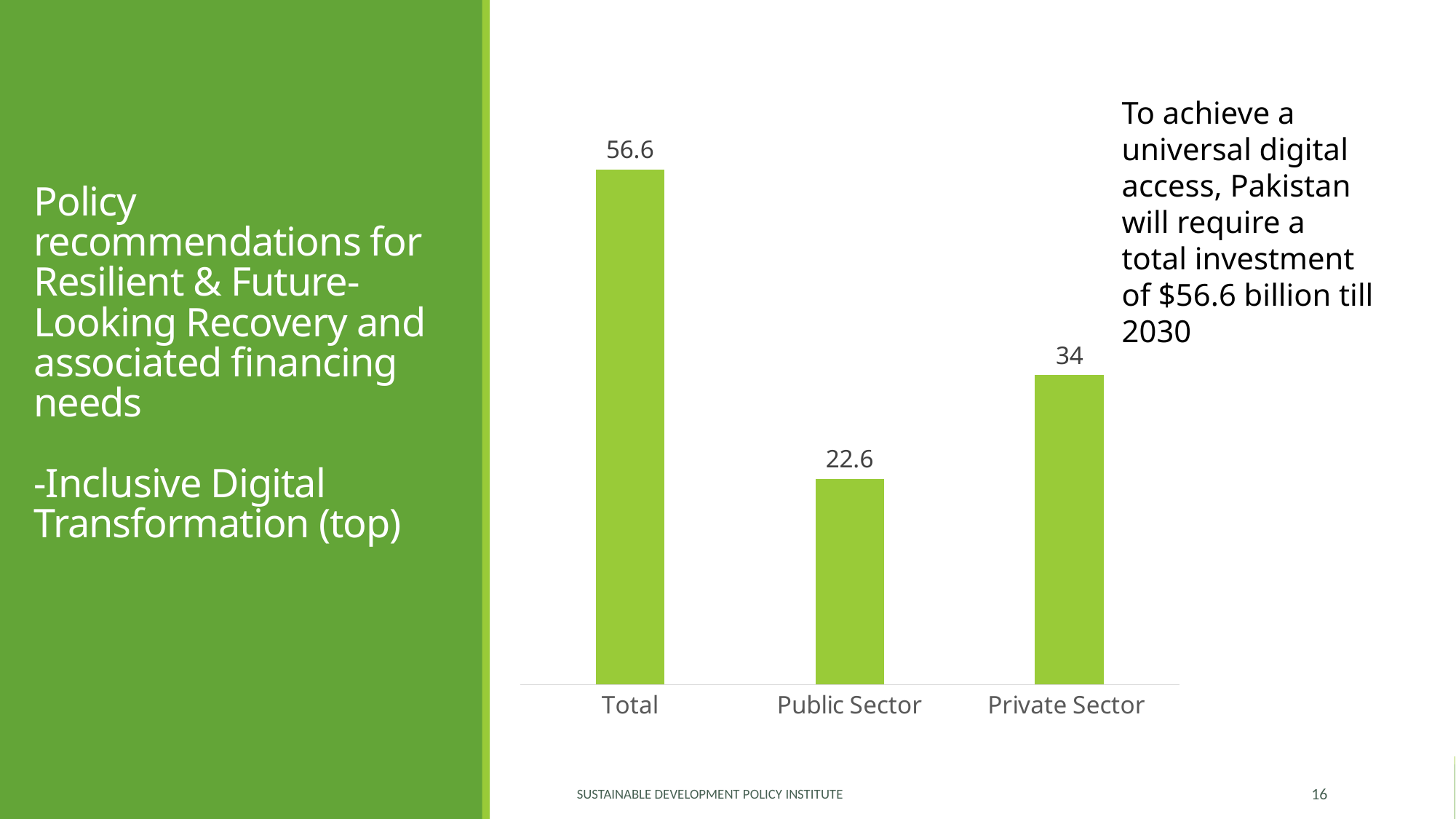
What is the value for Public Sector? 22.6 What colour are the bars in the chart? Green What is the difference between the Private Sector and Public Sector values? 11.4 Which category has the highest value? Total Which category is shown on the far left of the x axis? Total How many categories are shown on the chart? 3 What kind of chart is shown on the slide? Bar chart What is the value for Total? 56.6 Which is larger, the value for Public Sector or the value for Private Sector? Private Sector What is the value for Private Sector? 34 Which category has the lowest value? Public Sector What is the difference between the Total and Private Sector values? 22.6